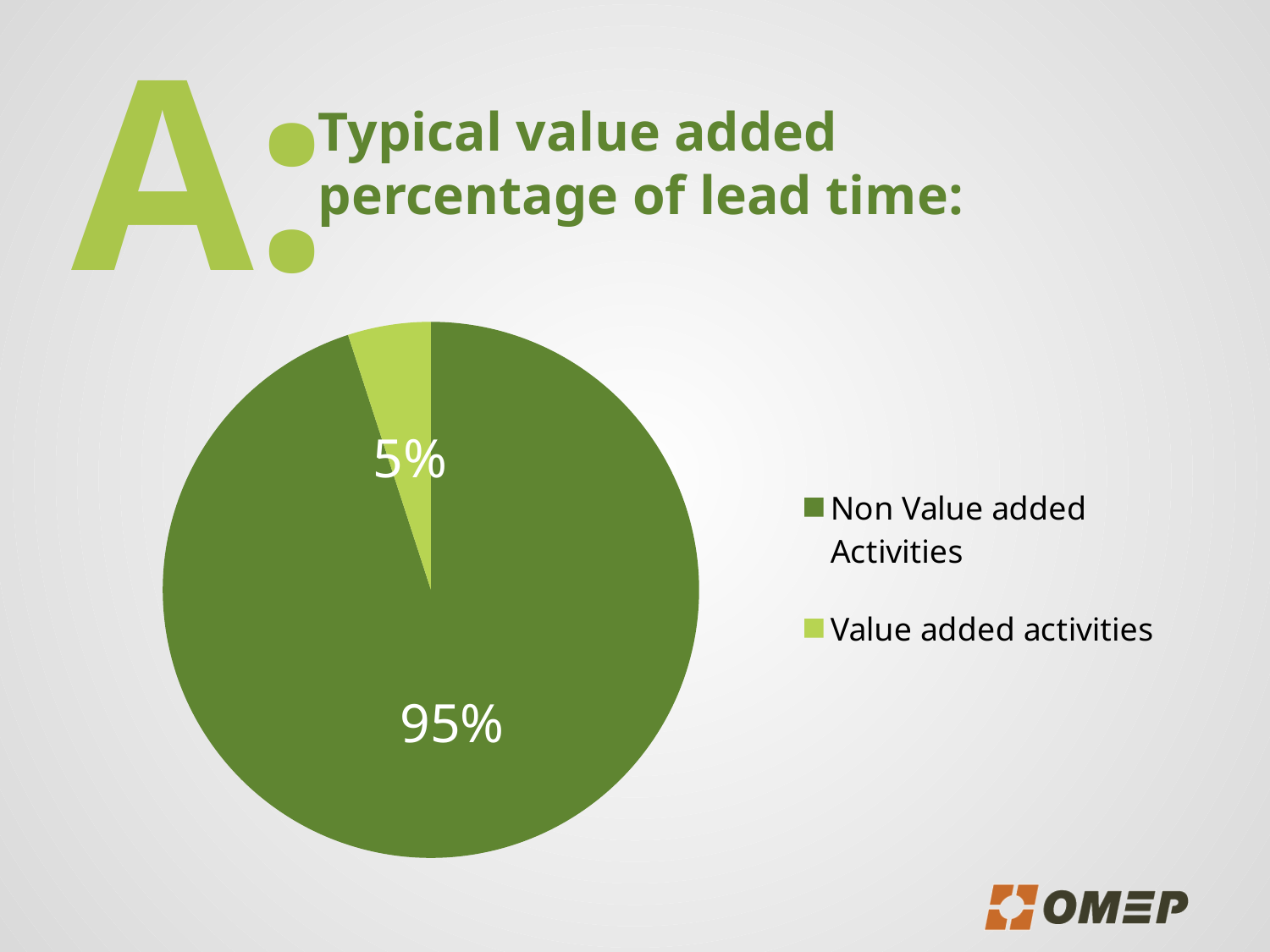
Which slice of the pie is the largest? Non Value added Activities What kind of chart is shown on the slide? pie chart What is the difference between the Non Value added Activities share and the Value added activities share? 90% What percentage of lead time is shown for Non Value added Activities? 95% How many entries does the legend list? 2 What share of the pie does the Value added activities slice take? 5% How many slices does the pie chart have? 2 What percentage of lead time is shown for Value added activities? 5% Which is larger, the share for Non Value added Activities or for Value added activities? Non Value added Activities Which slice of the pie is the smallest? Value added activities What colour is the Value added activities slice? light green What is the title text above the pie chart? Typical value added percentage of lead time: